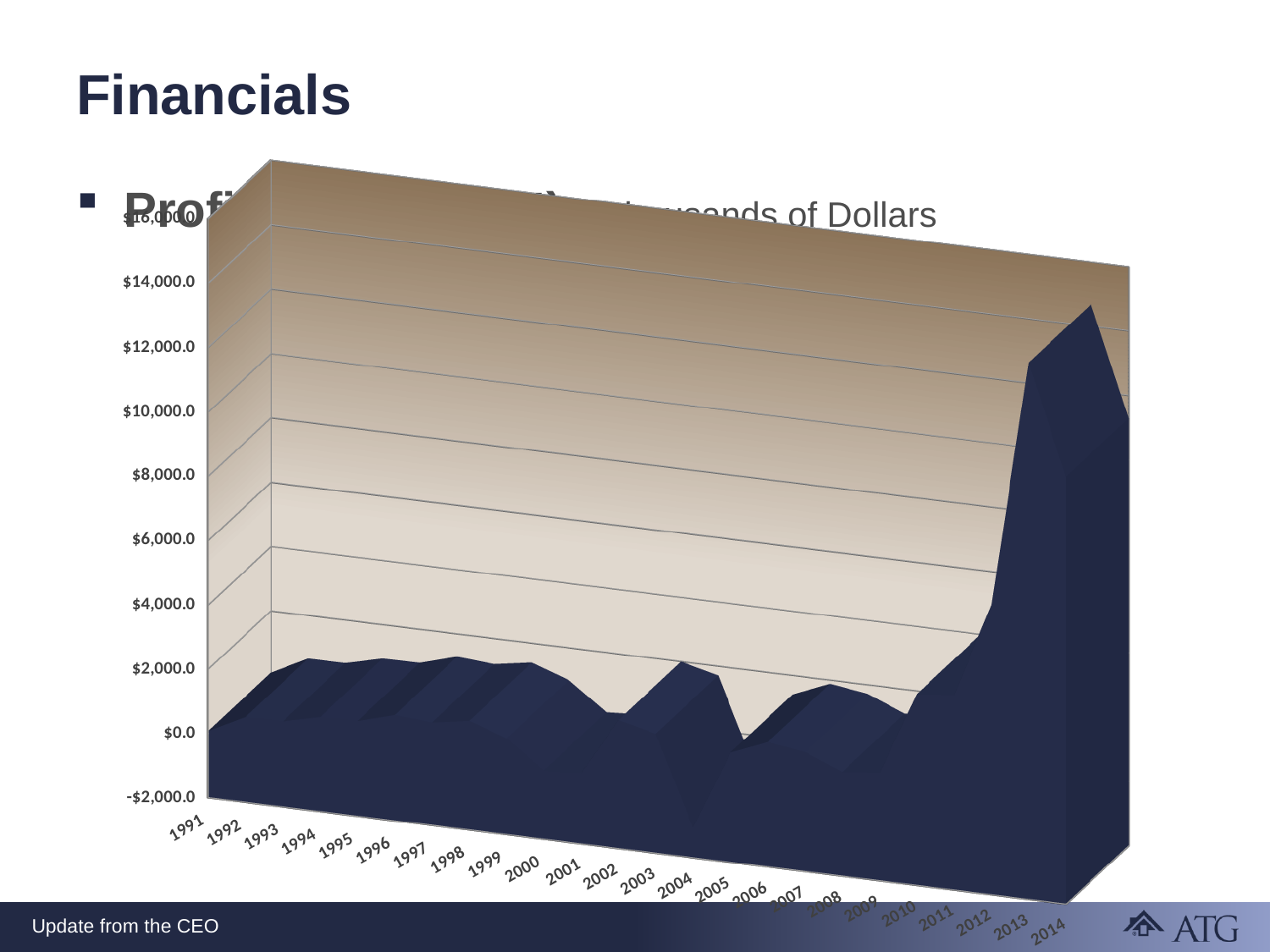
What is the lowest tick label shown on the y axis of the chart? -$2,000.0 Is the value for 2013 greater or less than $10,000.0? greater Is the value for 2005 greater or less than $2,000.0? less Do the values rise or fall from 2010 to 2013? rise What is the highest tick label shown on the y axis of the chart? $16,000.0 Which year has the larger value, 2013 or 2000? 2013 How many years are plotted along the x axis of the chart? 24 What kind of chart is shown on the slide? area chart Which year has the larger value, 2004 or 2005? 2005 Is the value for 1991 greater or less than $2,000.0? less Which year has the highest value in the chart? 2013